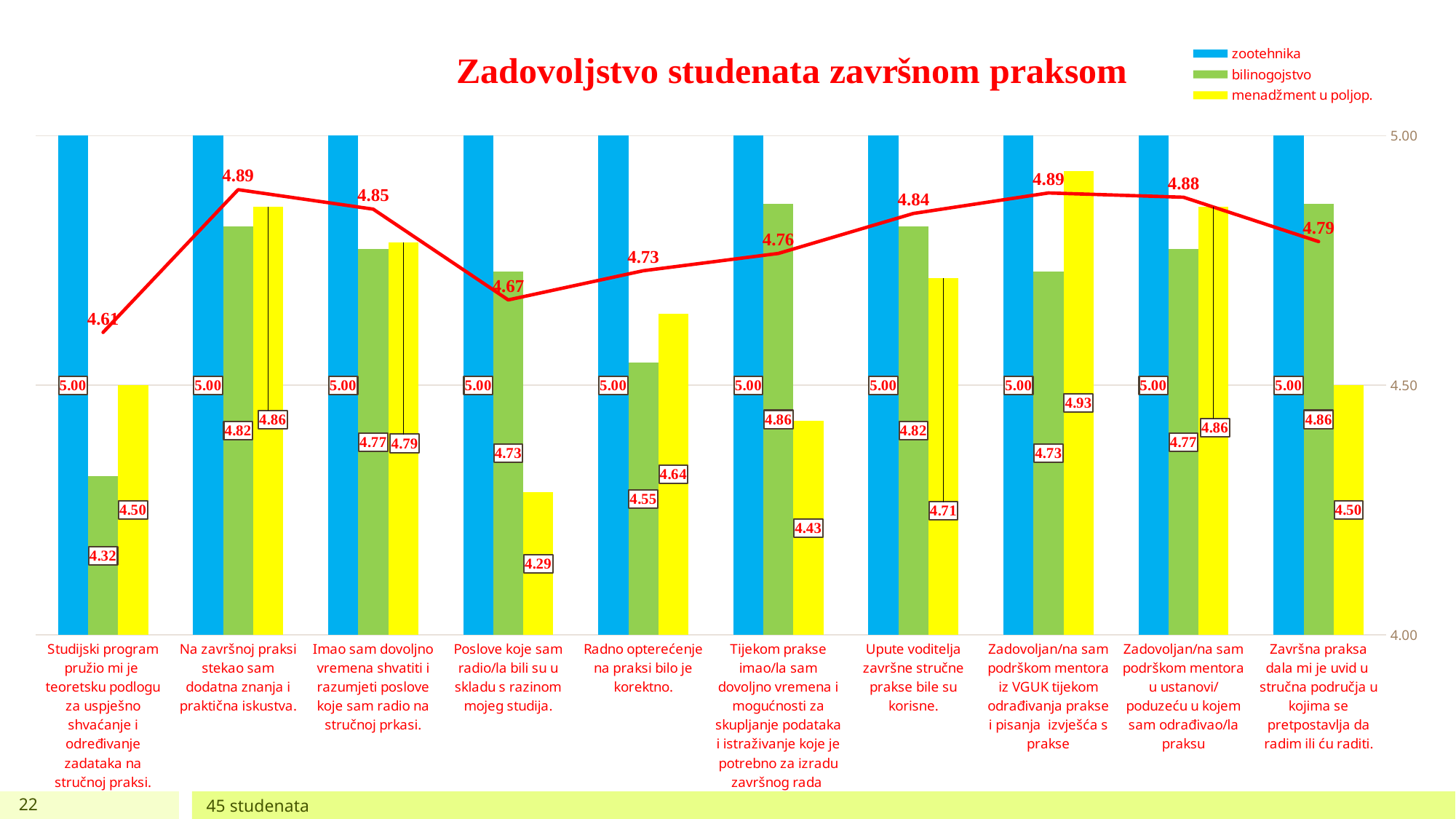
In which category is the menadžment u poljop. value highest? Zadovoljan/na sam podrškom mentora iz VGUK tijekom odrađivanja prakse i pisanja izvješća s prakse How many categories are shown on the x axis? 10 What value does the red line show for the category "Radno opterećenje na praksi bilo je korektno."? 4.73 What is the value for bilinogojstvo in the category "Studijski program pružio mi je teoretsku podlogu..."? 4.32 What is the difference between the bilinogojstvo and menadžment u poljop. values in the category "Tijekom prakse imao/la sam dovoljno vremena..."? 0.43 What is the value for menadžment u poljop. in the category "Poslove koje sam radio/la bili su u skladu s razinom mojeg studija."? 4.29 What is the value for zootehnika in the category "Radno opterećenje na praksi bilo je korektno."? 5.00 In which category is the bilinogojstvo value lowest? Studijski program pružio mi je teoretsku podlogu za uspješno shvaćanje i određivanje zadataka na stručnoj praksi. How many series does the legend list? 3 Is the menadžment u poljop. value for "Upute voditelja završne stručne prakse bile su korisne." greater or less than 4.50? greater What is the title of the chart? Zadovoljstvo studenata završnom praksom In the category "Radno opterećenje na praksi bilo je korektno.", which is larger: bilinogojstvo or menadžment u poljop.? menadžment u poljop.